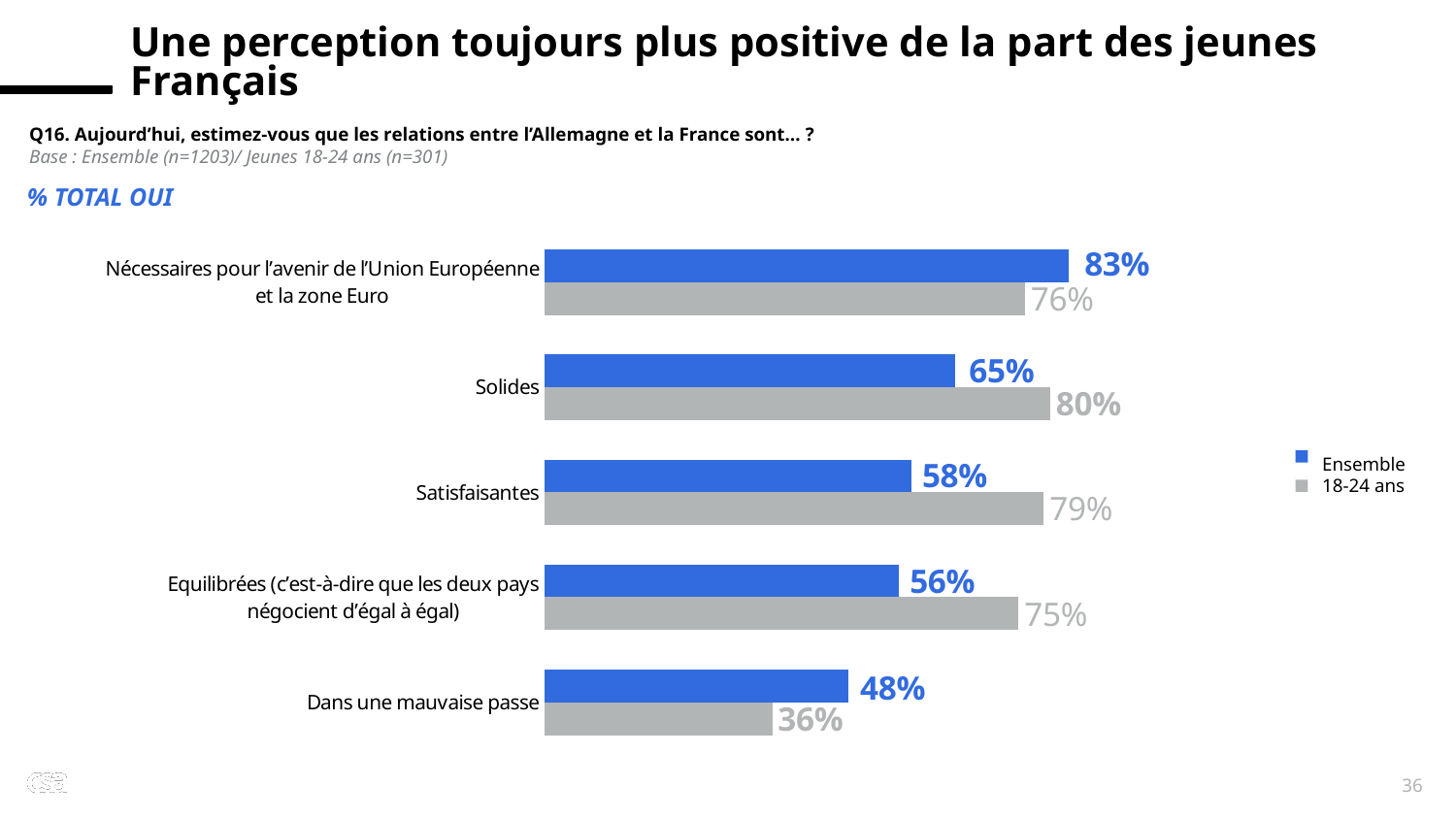
How many series does the legend list? 2 How many categories are shown in the chart? 5 What is the difference between the 18-24 ans and Ensemble values for "Solides"? 15% What is the difference between the Ensemble and 18-24 ans values for "Dans une mauvaise passe"? 12% What is the 18-24 ans value for "Dans une mauvaise passe"? 36% What kind of chart is shown on the slide? Bar chart What is the 18-24 ans value for "Satisfaisantes"? 79% For "Equilibrées (c'est-à-dire que les deux pays négocient d'égal à égal)", which series has the larger value, Ensemble or 18-24 ans? 18-24 ans Which category has the highest Ensemble value? Nécessaires pour l'avenir de l'Union Européenne et la zone Euro Which category has the lowest 18-24 ans value? Dans une mauvaise passe What is the Ensemble value for "Solides"? 65% Which category has the highest 18-24 ans value? Solides